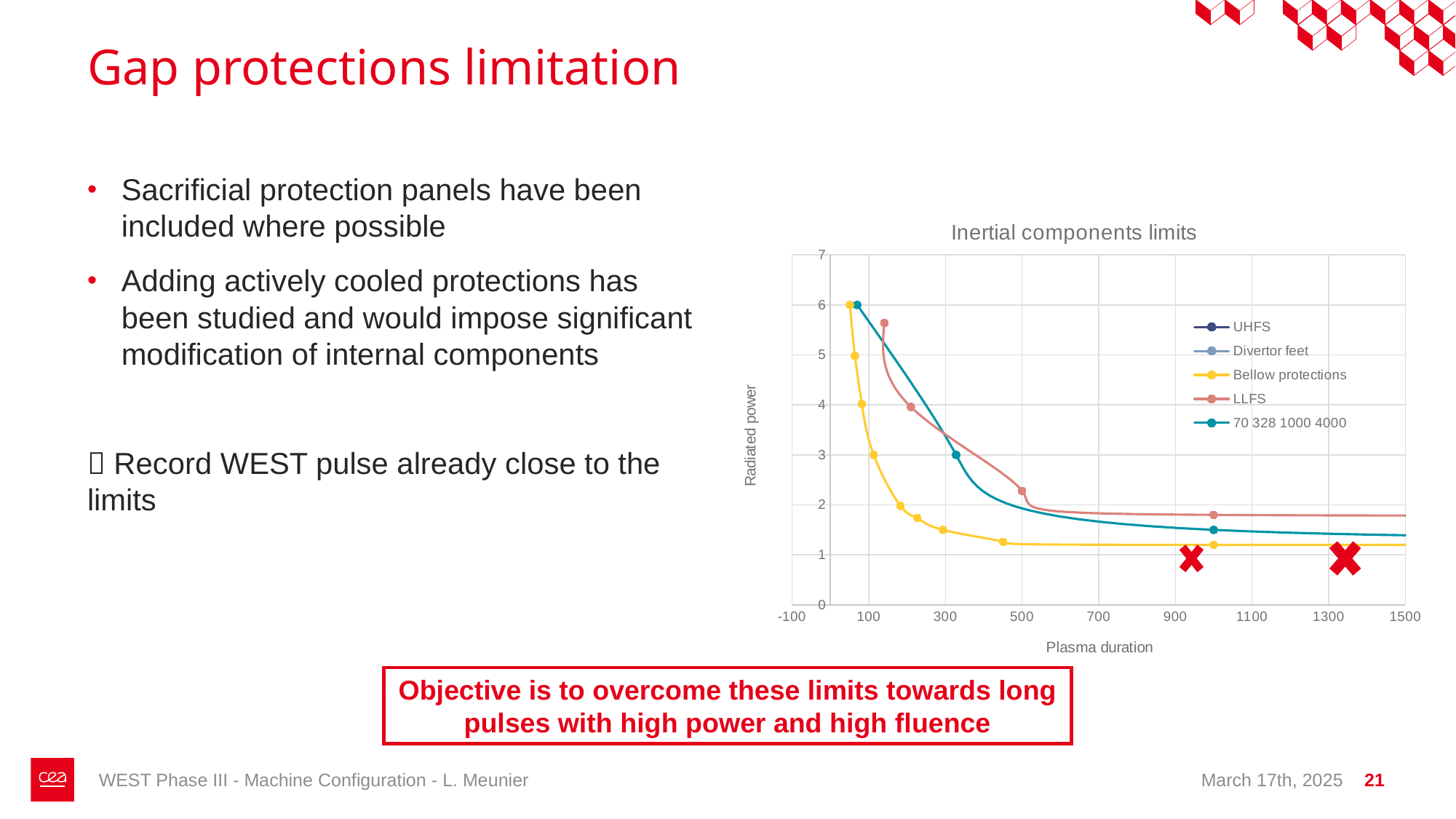
What is the title of the chart? Inertial components limits What type of chart is shown on the slide? line chart Is the value for the 70 328 1000 4000 series at a plasma duration of 1000 greater or less than 2? less Is the value for Bellow protections at a plasma duration of 1000 greater or less than 2? less Is the first LLFS point (near a plasma duration of 100) greater or less than 5? greater At a plasma duration of 1000, which series has the higher radiated power: LLFS or Bellow protections? LLFS What is the label of the x axis of the chart? Plasma duration Do the values of the Bellow protections series rise or fall as plasma duration increases? fall Which series has the lowest radiated power at a plasma duration of 1000? Bellow protections How many data points are marked on the LLFS series? 4 How many data points are marked on the 70 328 1000 4000 series? 3 How many series does the chart legend list? 5